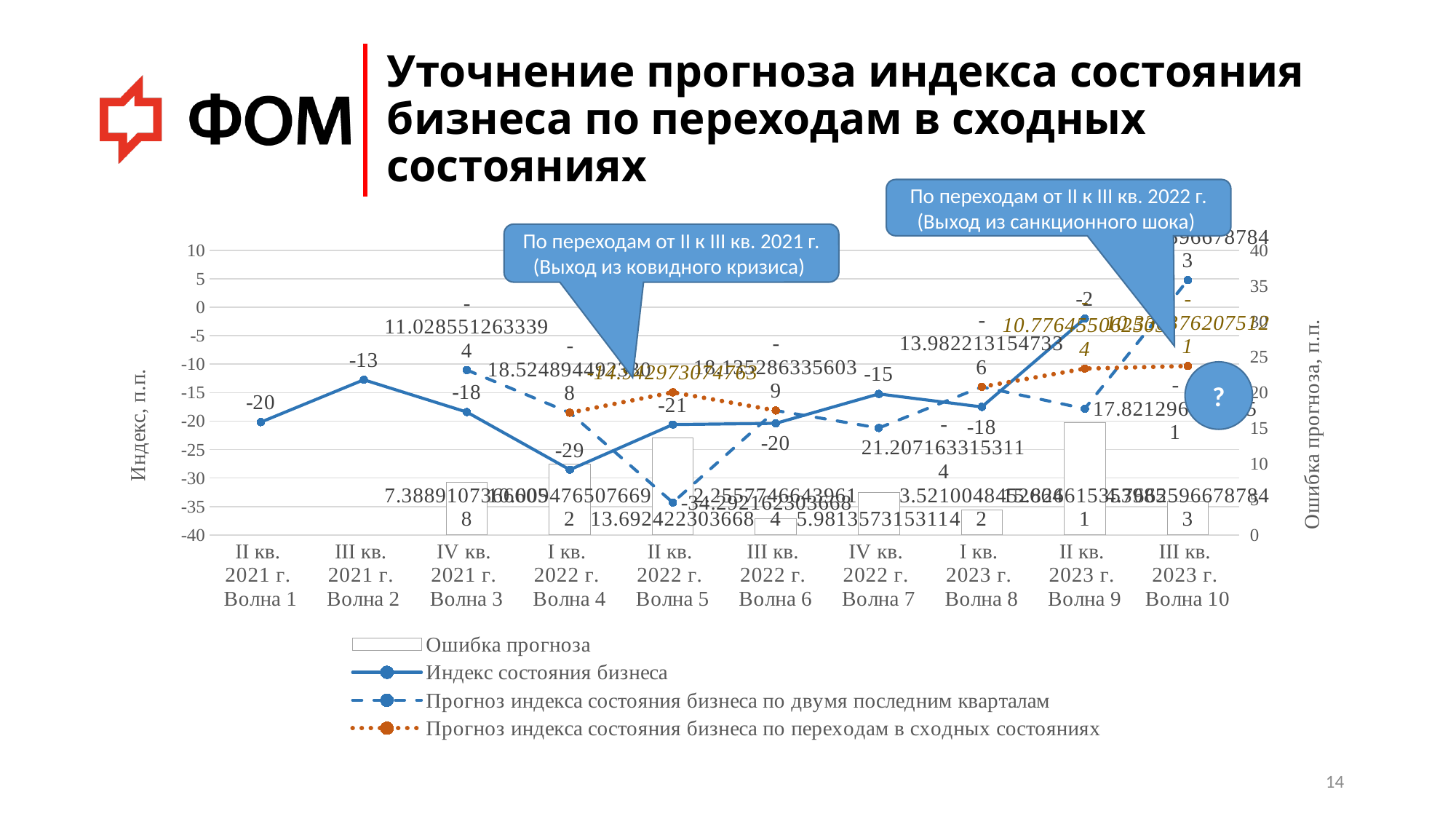
How many waves (categories) are shown on the x axis? 10 How many series does the chart legend list? 4 What kind of chart is shown on the slide? A combined bar and line chart What is the value of Индекс состояния бизнеса for III кв. 2021 г. Волна 2? -13 What is the value of Индекс состояния бизнеса for I кв. 2022 г. Волна 4? -29 What is the difference between Индекс состояния бизнеса in Волна 9 (-2) and Волна 4 (-29)? 27 In which wave is Индекс состояния бизнеса the lowest? I кв. 2022 г. Волна 4 In which wave is Индекс состояния бизнеса the highest? II кв. 2023 г. Волна 9 Which is larger, Индекс состояния бизнеса in IV кв. 2022 г. Волна 7 or in I кв. 2023 г. Волна 8? IV кв. 2022 г. Волна 7 What is the title of the left vertical axis? Индекс, п.п.